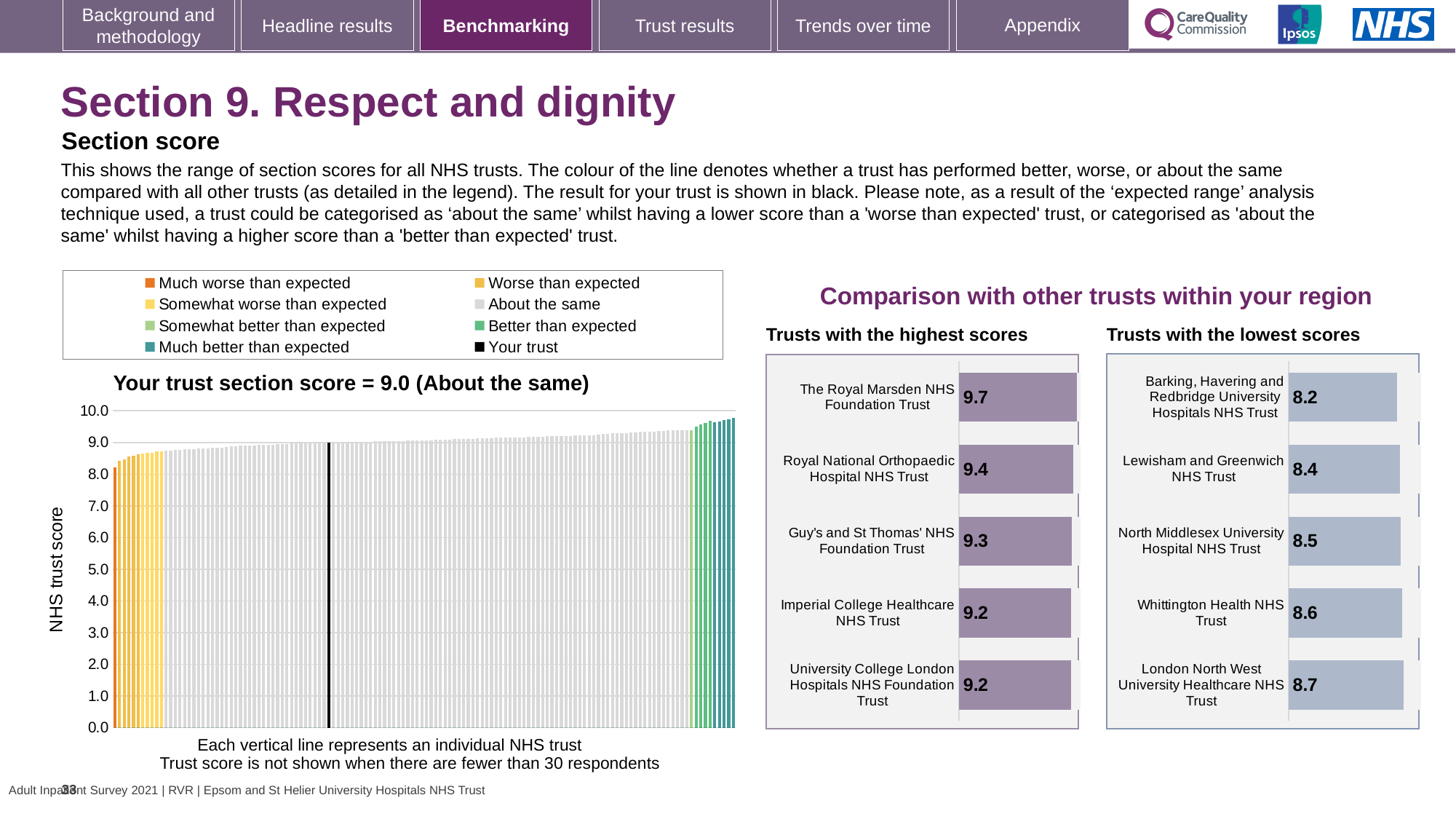
In the 'Your trust section score' chart, what category is your trust placed in? About the same In the 'Trusts with the lowest scores' chart, what is the score for Whittington Health NHS Trust? 8.6 How many trusts are shown in the 'Trusts with the lowest scores' chart? 5 What kind of chart is the 'Your trust section score' chart? bar chart How many entries does the legend above the 'Your trust section score' chart list? 8 In the 'Trusts with the highest scores' chart, what is the score for The Royal Marsden NHS Foundation Trust? 9.7 In the 'Trusts with the highest scores' chart, which trust has the highest score? The Royal Marsden NHS Foundation Trust In the 'Your trust section score' chart, what is the section score for your trust? 9.0 In the 'Your trust section score' chart, do the trust scores rise or fall from left to right along the x axis? rise In the 'Your trust section score' chart, is the value for your trust greater or less than 8.0? greater In the 'Trusts with the highest scores' chart, what is the difference between the scores of The Royal Marsden NHS Foundation Trust and Royal National Orthopaedic Hospital NHS Trust? 0.3 In the 'Trusts with the lowest scores' chart, which trust has the lowest score? Barking, Havering and Redbridge University Hospitals NHS Trust